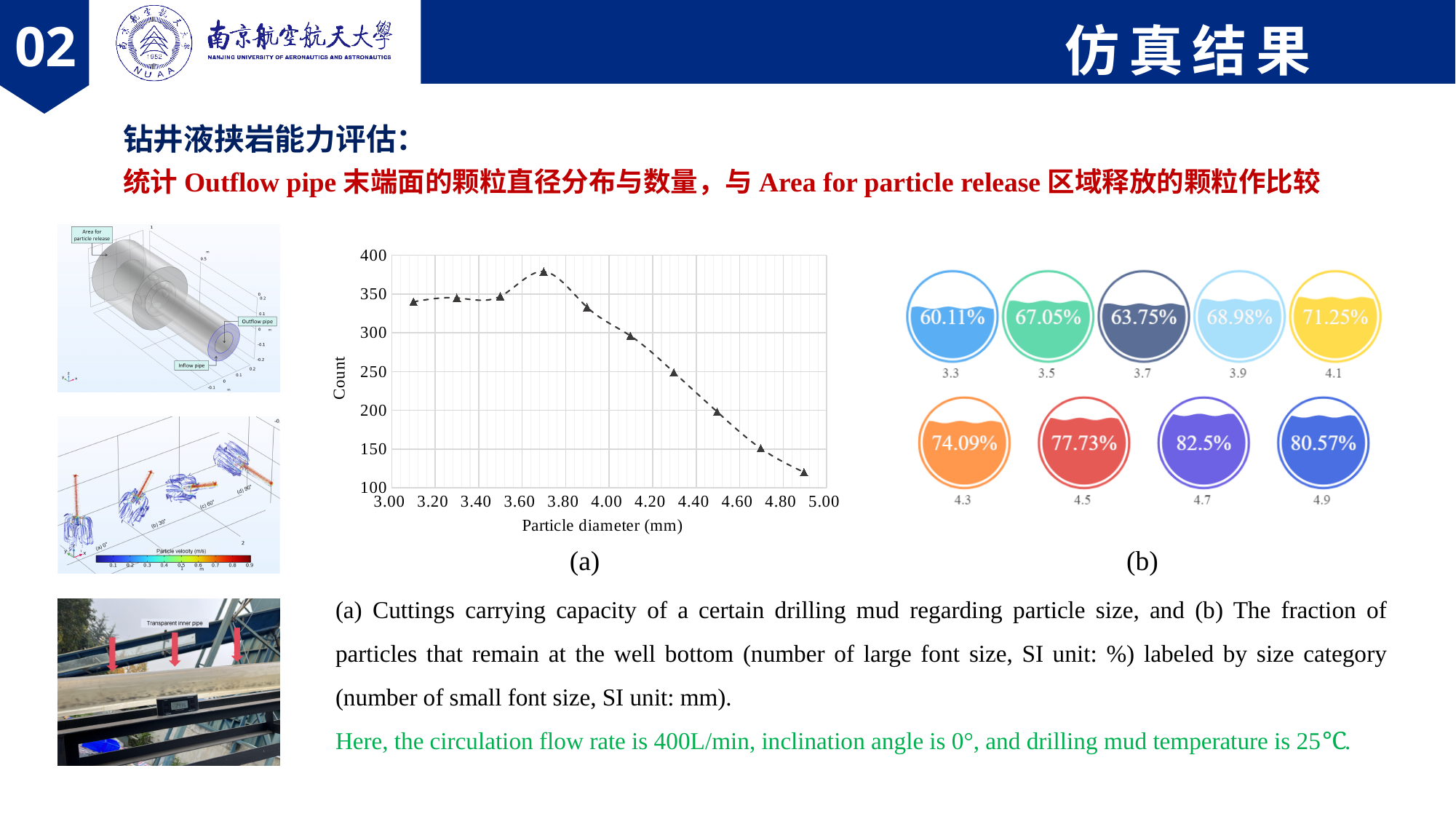
In chart (a), is the Count at a particle diameter of 3.70 mm greater or less than 350? greater In chart (b), what is the difference between the fractions for the 4.5 mm and 3.5 mm size categories? 10.68% In chart (b), which size category has the larger fraction, 3.7 or 3.9? 3.9 In chart (a), is the Count at a particle diameter of 4.30 mm greater or less than 300? less In chart (a), what kind of chart is used to show Count against Particle diameter? line chart In chart (a), how many data points are plotted? 10 In chart (b), which size category has the highest fraction of particles remaining at the well bottom? 4.7 In chart (a), at which particle diameter is the Count highest? 3.70 mm In chart (a), does the Count rise or fall as particle diameter increases from 3.70 mm to 4.90 mm? fall In chart (b), what fraction of particles remains at the well bottom for the 4.1 mm size category? 71.25% In chart (a), at which particle diameter is the Count lowest? 4.90 mm In chart (b), which size category has the lowest fraction of particles remaining at the well bottom? 3.3